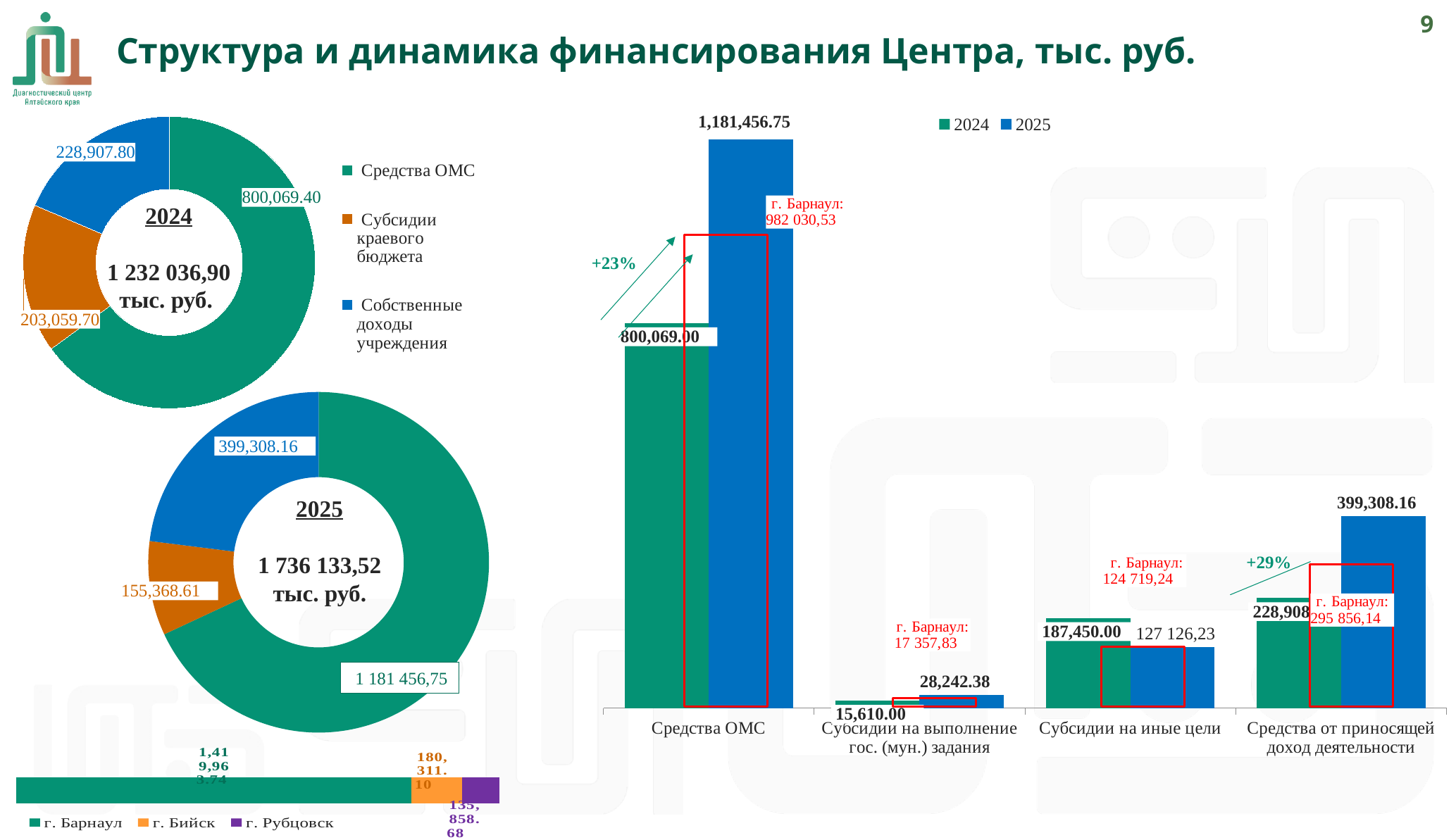
In the 2025 donut chart, which category has the smallest slice? Субсидии краевого бюджета How many series does the legend of the bar chart on the right list? 2 In the bar chart on the right, for Субсидии на иные цели, which year has the larger value, 2024 or 2025? 2024 In the bar chart on the right, what is the 2024 value for Субсидии на иные цели? 187,450.00 How many categories are shown on the x axis of the bar chart on the right? 4 In the 2024 donut chart, what is the value for Средства ОМС? 800,069.40 What total is shown in the centre of the 2025 donut chart? 1 736 133,52 тыс. руб. In the 2024 donut chart, what is the difference between Собственные доходы учреждения and Субсидии краевого бюджета? 25,848.10 In the bar chart on the right, what is the difference between the 2025 and 2024 values for Средства ОМС? 381,387.75 In the 2025 donut chart, what is the value for Собственные доходы учреждения? 399,308.16 In the 2024 donut chart, which category has the largest slice? Средства ОМС In the bar chart on the right, what is the 2025 value for Субсидии на выполнение гос. (мун.) задания? 28,242.38